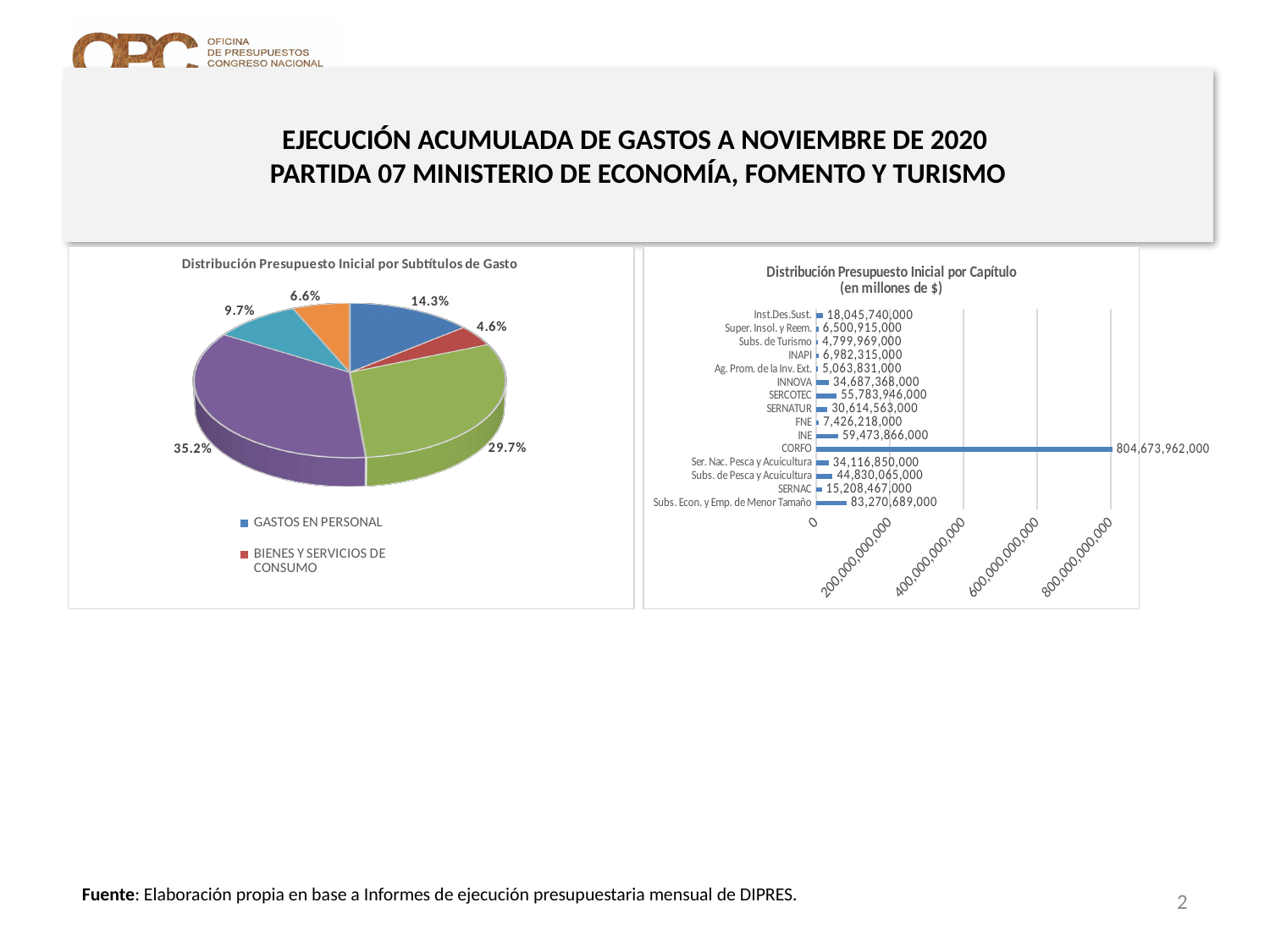
In the bar chart 'Distribución Presupuesto Inicial por Capítulo', which category has the highest value? CORFO In the bar chart 'Distribución Presupuesto Inicial por Capítulo', is the value for CORFO greater or less than 600,000,000,000? greater In the bar chart 'Distribución Presupuesto Inicial por Capítulo', which category has the lowest value? Subs. de Turismo In the bar chart 'Distribución Presupuesto Inicial por Capítulo', what is the value for SERCOTEC? 55,783,946,000 In the pie chart 'Distribución Presupuesto Inicial por Subtítulos de Gasto', what share does GASTOS EN PERSONAL have? 14.3% In the bar chart 'Distribución Presupuesto Inicial por Capítulo', what is the value for Subs. Econ. y Emp. de Menor Tamaño? 83,270,689,000 In the bar chart 'Distribución Presupuesto Inicial por Capítulo', what is the difference between the values for INE and SERNATUR? 28,859,303,000 In the bar chart 'Distribución Presupuesto Inicial por Capítulo', which is larger, the value for INNOVA or the value for Ser. Nac. Pesca y Acuicultura? INNOVA How many categories are shown in the bar chart 'Distribución Presupuesto Inicial por Capítulo'? 15 In the bar chart 'Distribución Presupuesto Inicial por Capítulo', what is the value for CORFO? 804,673,962,000 In the pie chart 'Distribución Presupuesto Inicial por Subtítulos de Gasto', what is the largest percentage shown? 35.2% What kind of chart is 'Distribución Presupuesto Inicial por Subtítulos de Gasto'? Pie chart